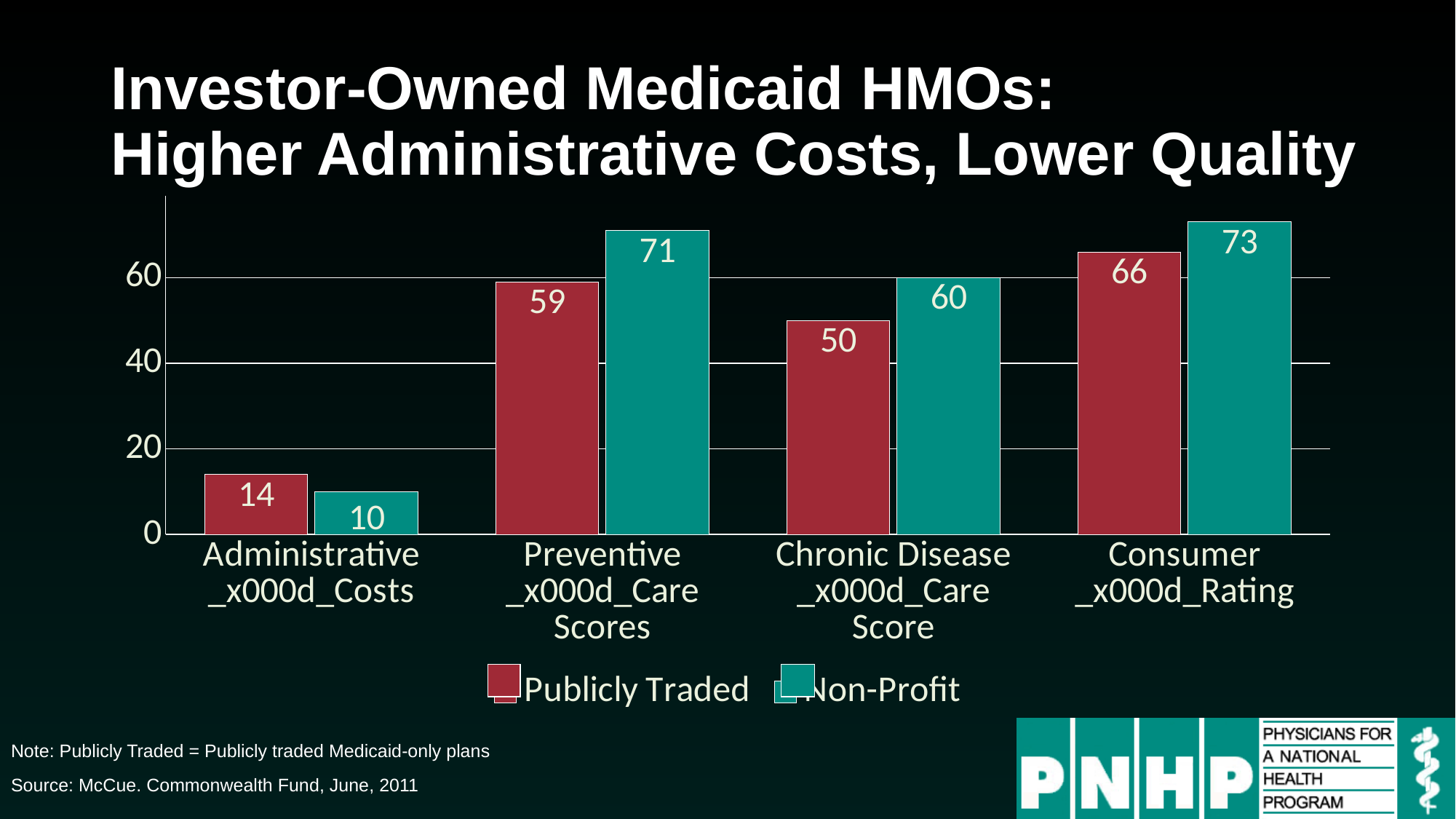
How many categories are shown on the x axis? 4 What kind of chart is shown on the slide? Bar chart For Administrative Costs, which series has the larger value, Publicly Traded or Non-Profit? Publicly Traded What is the Non-Profit value for Consumer Rating? 73 Which category has the highest Non-Profit value? Consumer Rating What colour are the Non-Profit bars? Teal What is the Publicly Traded value for Chronic Disease Care Score? 50 What is the difference between the Non-Profit and Publicly Traded values for Preventive Care Scores? 12 What is the Publicly Traded value for Administrative Costs? 14 Which category has the lowest Publicly Traded value? Administrative Costs How many series does the legend list? 2 What is the Non-Profit value for Preventive Care Scores? 71